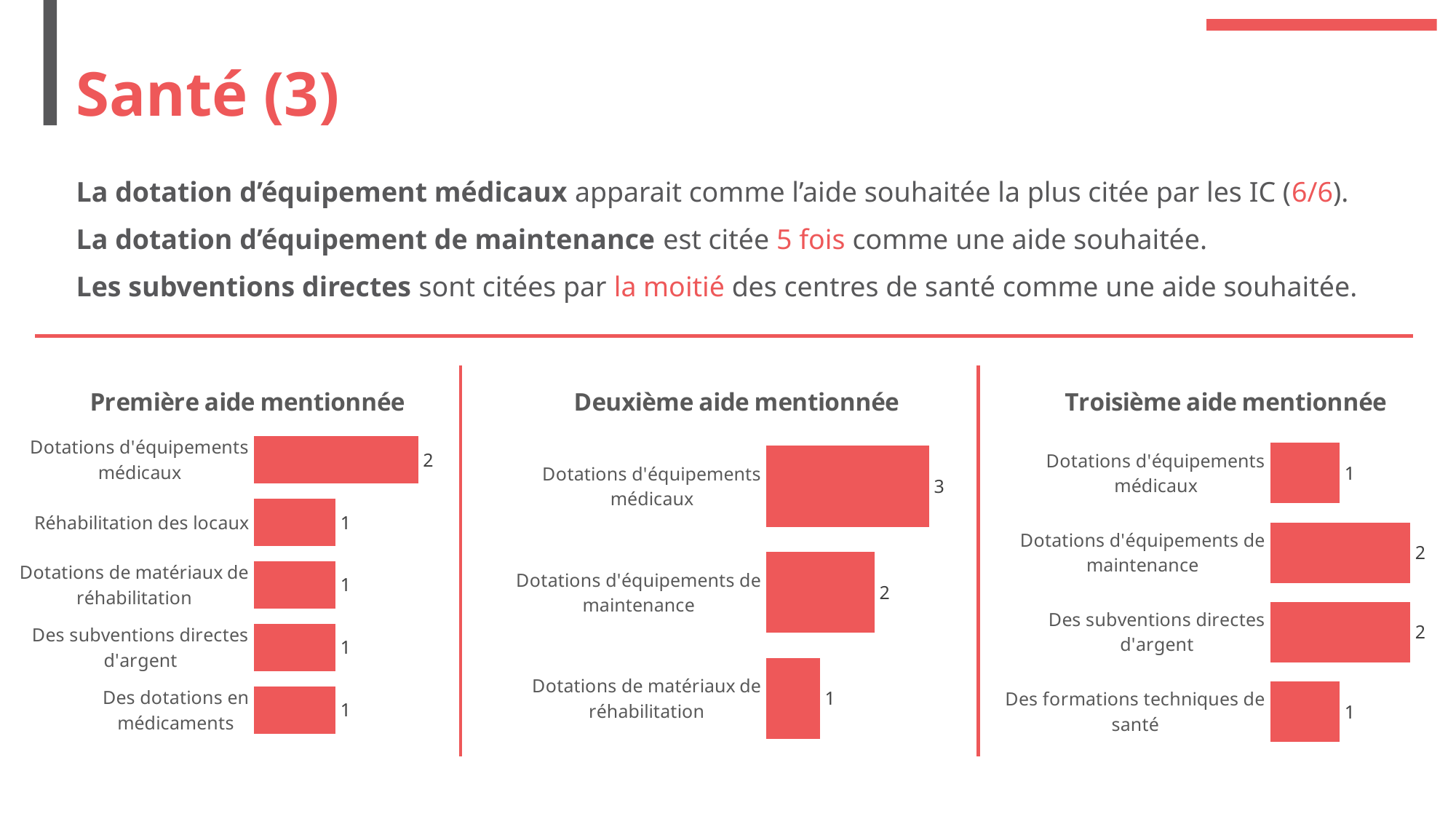
How many categories does the 'Troisième aide mentionnée' chart show? 4 In the 'Troisième aide mentionnée' chart, what is the value for Des formations techniques de santé? 1 In the 'Deuxième aide mentionnée' chart, what is the difference between Dotations d'équipements médicaux and Dotations de matériaux de réhabilitation? 2 In the 'Deuxième aide mentionnée' chart, what is the value for Dotations d'équipements de maintenance? 2 In the 'Troisième aide mentionnée' chart, which is larger: Dotations d'équipements de maintenance or Dotations d'équipements médicaux? Dotations d'équipements de maintenance In the 'Première aide mentionnée' chart, what is the value for Dotations d'équipements médicaux? 2 In the 'Première aide mentionnée' chart, which category has the highest value? Dotations d'équipements médicaux How many categories does the 'Première aide mentionnée' chart show? 5 In the 'Deuxième aide mentionnée' chart, which category has the lowest value? Dotations de matériaux de réhabilitation How many categories does the 'Deuxième aide mentionnée' chart show? 3 What type of chart is the 'Troisième aide mentionnée' chart? Bar chart What is the title of the leftmost chart on the slide? Première aide mentionnée